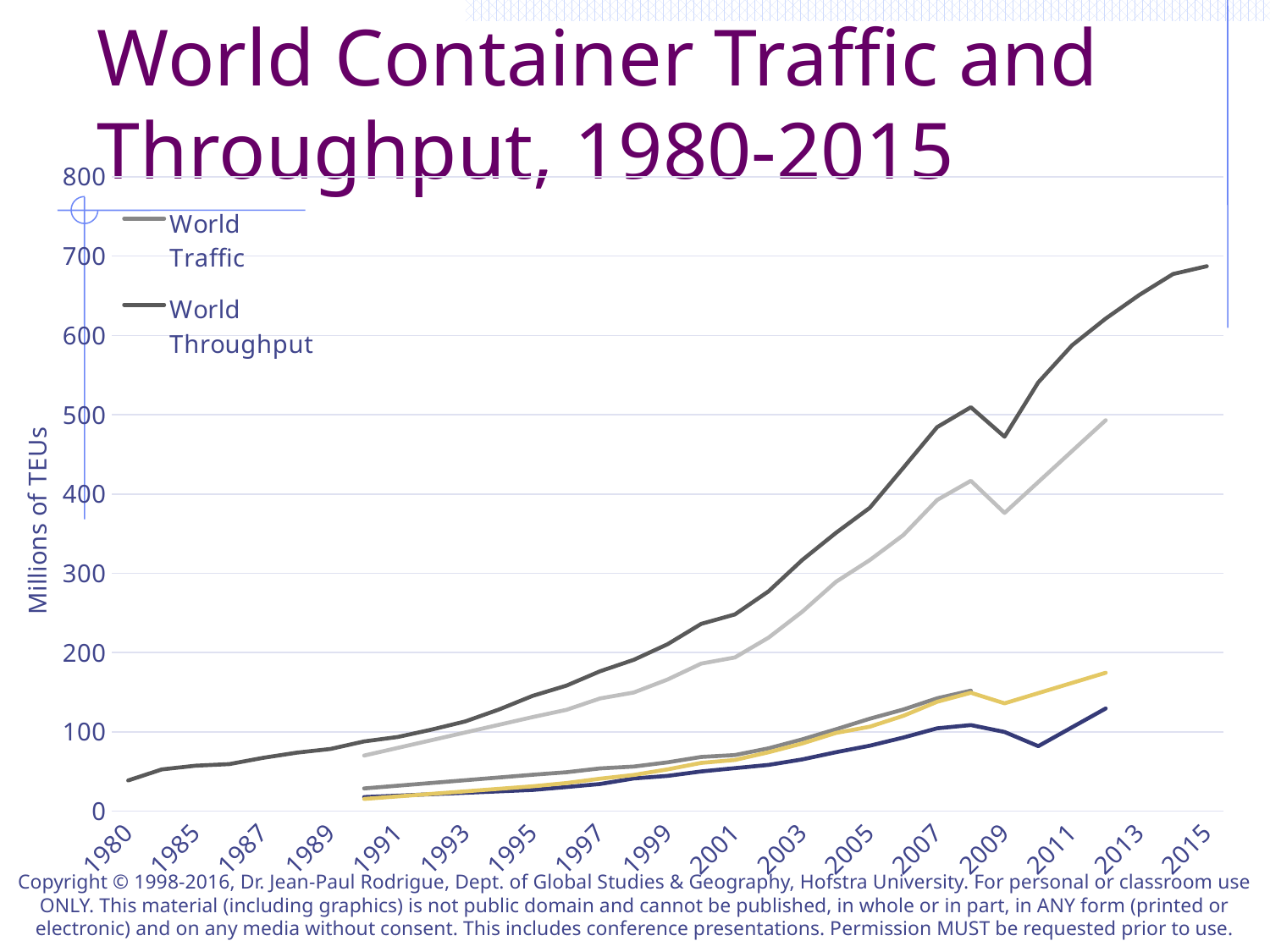
Is the value for World Throughput in 1980 greater or less than 100? less How many series does the legend list? 2 In 2007, which is larger, World Throughput or World Traffic? World Throughput In which year does World Throughput reach its highest value? 2015 Is the value for World Traffic in 2001 greater or less than 300? less Is the value for World Throughput in 2015 greater or less than 600? greater What is the label on the vertical axis? Millions of TEUs What is the title of the chart? World Container Traffic and Throughput, 1980-2015 What kind of chart is shown on the slide? line chart Overall, does World Throughput rise or fall from 1980 to 2015? rise